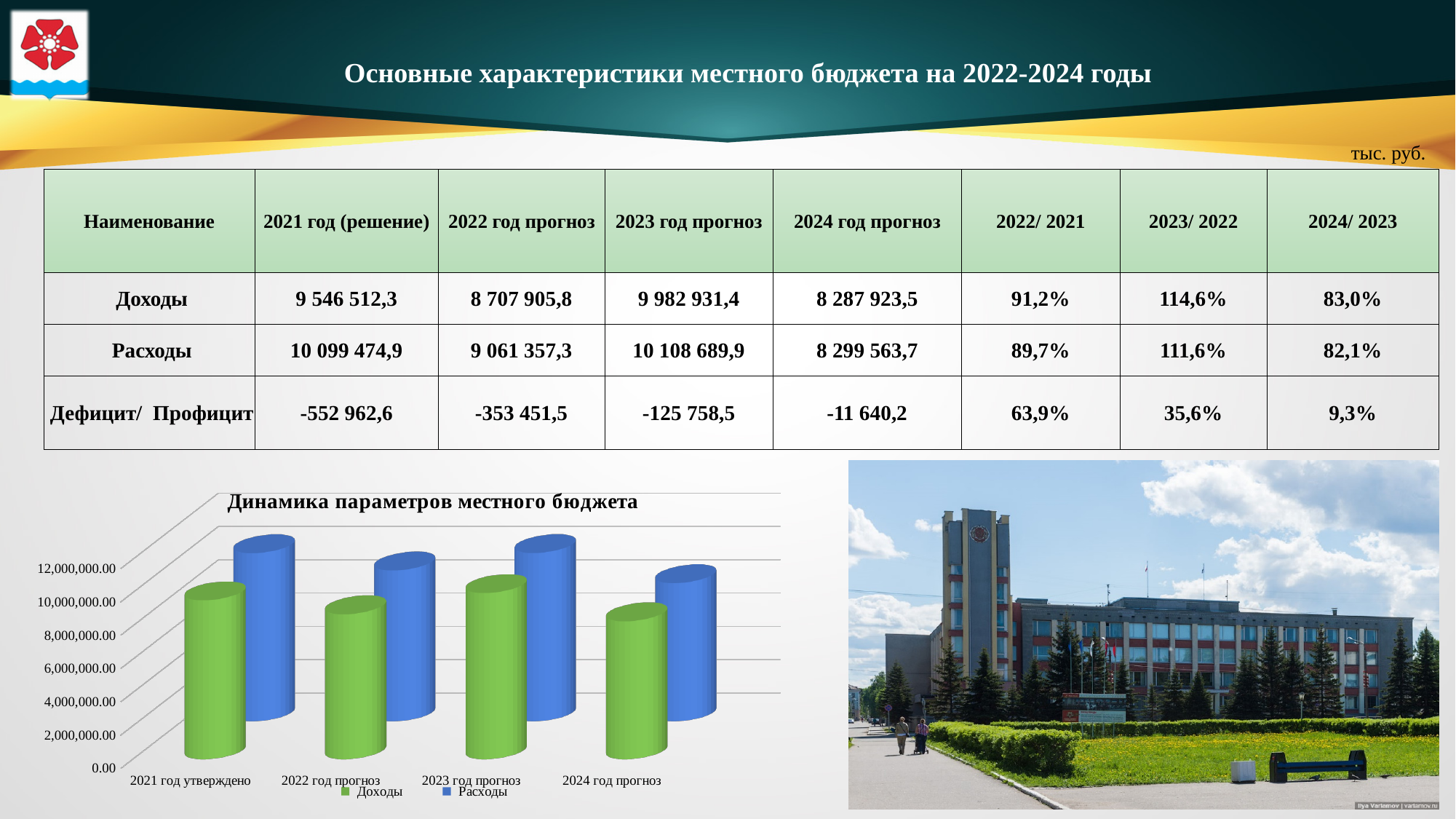
In the chart "Динамика параметров местного бюджета", which is larger for 2021 год утверждено: Доходы or Расходы? Расходы How many series does the legend of the chart "Динамика параметров местного бюджета" list? 2 What kind of chart is "Динамика параметров местного бюджета"? bar chart In the chart "Динамика параметров местного бюджета", which is larger for 2024 год прогноз: Доходы or Расходы? Расходы In the chart "Динамика параметров местного бюджета", is the value of Расходы for 2022 год прогноз greater or less than 8,000,000.00? greater How many categories are shown on the x axis of the chart "Динамика параметров местного бюджета"? 4 In the chart "Динамика параметров местного бюджета", which series is shown in green? Доходы In the chart "Динамика параметров местного бюджета", is the value of Доходы for 2022 год прогноз greater or less than 10,000,000.00? less In the chart "Динамика параметров местного бюджета", which category has the lowest value for Доходы? 2024 год прогноз In the chart "Динамика параметров местного бюджета", which category has the lowest value for Расходы? 2024 год прогноз In the chart "Динамика параметров местного бюджета", is the value of Доходы for 2024 год прогноз greater or less than 10,000,000.00? less In the chart "Динамика параметров местного бюджета", which series is shown in blue? Расходы